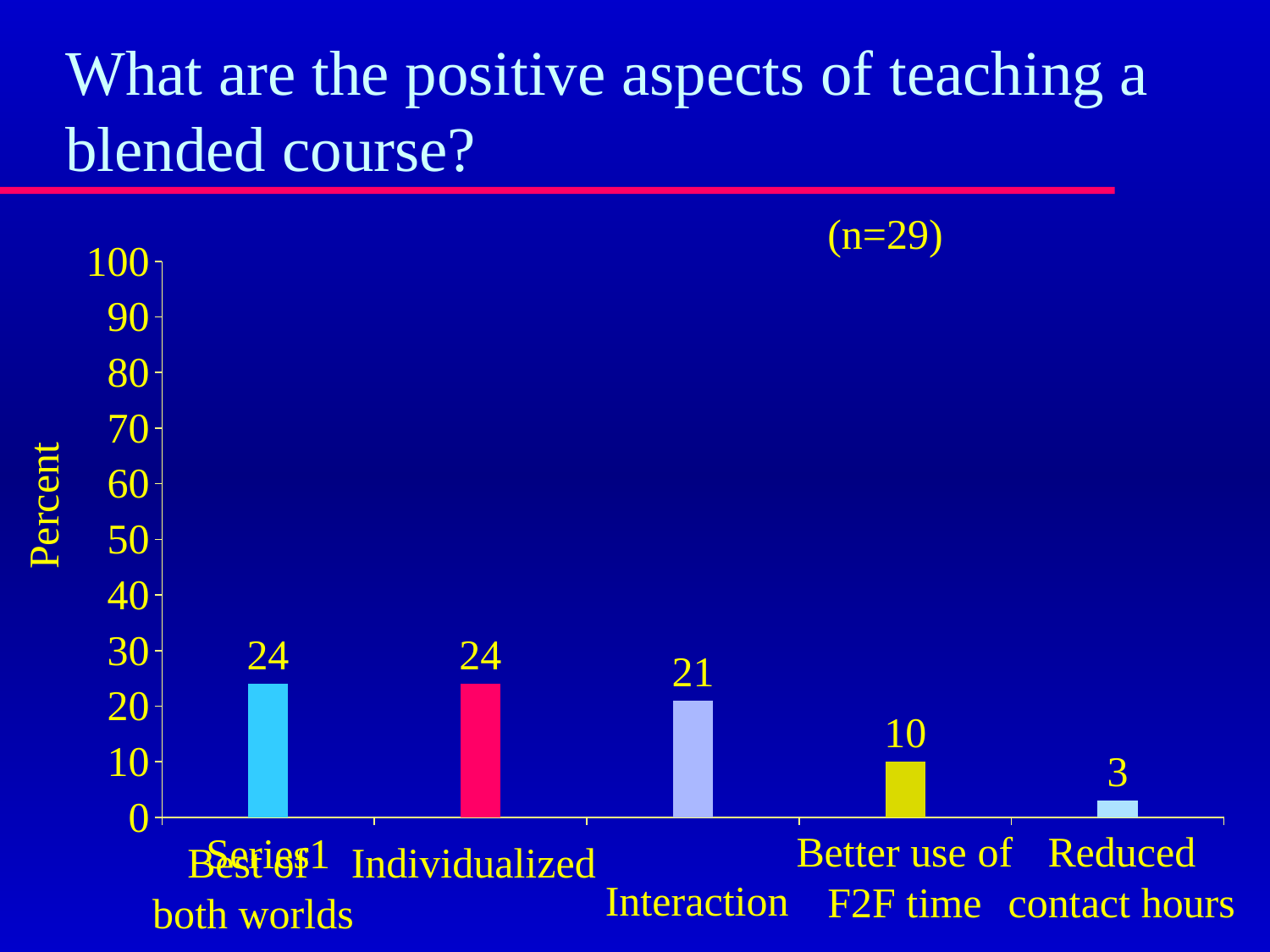
What is the value for Reduced contact hours? 3 What is the value for Interaction? 21 How many categories are shown in the chart? 5 What is the difference between the values for Interaction and Better use of F2F time? 11 What is the label on the vertical axis? Percent Do the values rise or fall from left to right across the categories? Fall Which is larger, the value for Interaction or the value for Better use of F2F time? Interaction What kind of chart is shown on the slide? Bar chart What is the value for Better use of F2F time? 10 What is the value for Individualized? 24 Which category has the lowest value? Reduced contact hours What is the difference between the values for Individualized and Reduced contact hours? 21